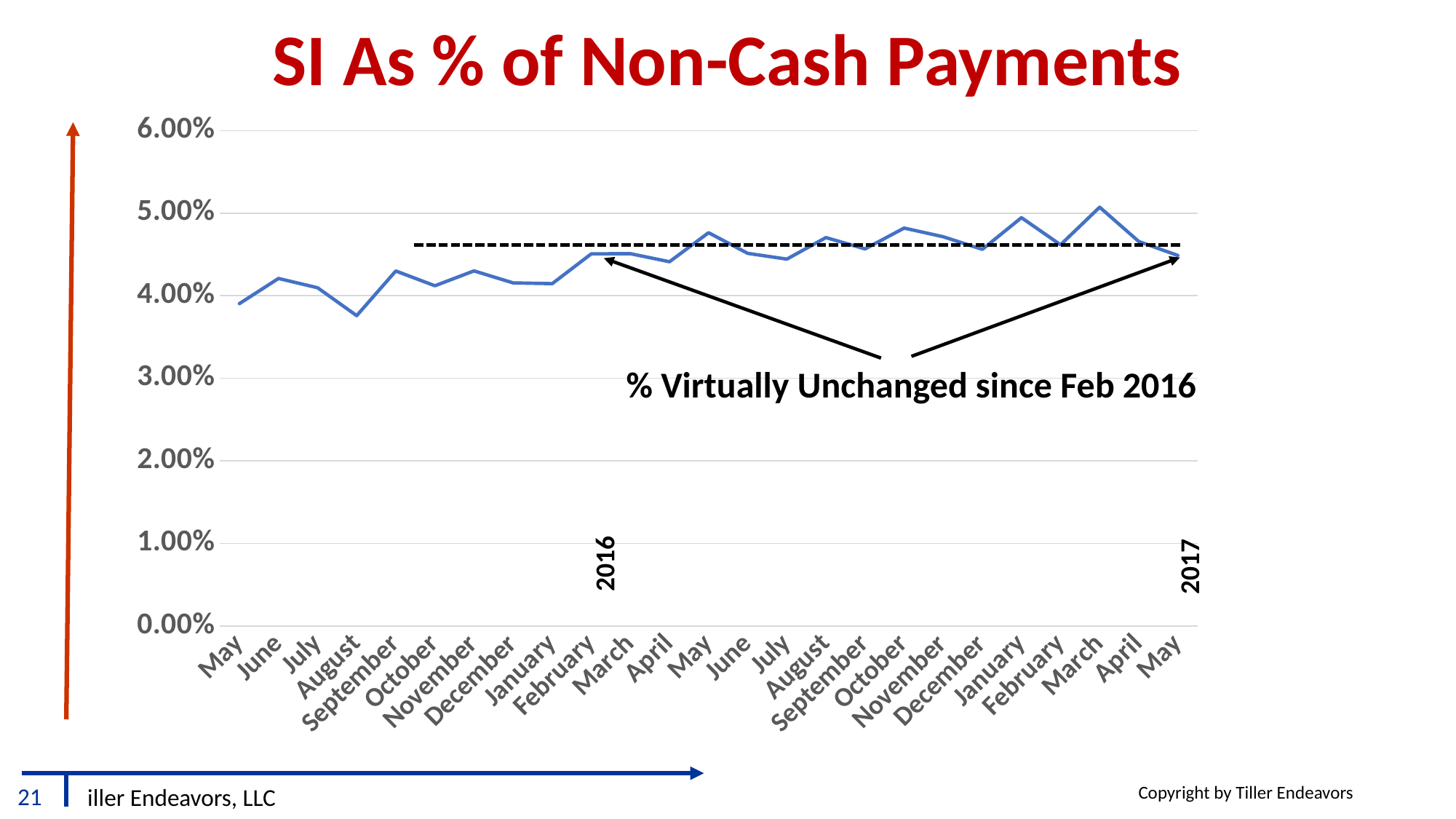
How many monthly data points are plotted on the line? 25 What kind of chart is shown on the slide? line chart Is the value for March 2017 greater or less than 5.00%? greater Overall, do the values rise or fall from the left of the x axis to the right? rise Which month has the lowest value on the chart? August (the first August, 2015) What is the title of the chart? SI As % of Non-Cash Payments Which is larger: the value for the first May (leftmost point) or the value for May 2017 (rightmost point)? May 2017 Which month has the highest value on the chart? March 2017 Is the value for May 2016 greater or less than 4.00%? greater Is the value for the first August shown (before the 2016 marker) greater or less than 4.00%? less What does the annotation text on the chart say? % Virtually Unchanged since Feb 2016